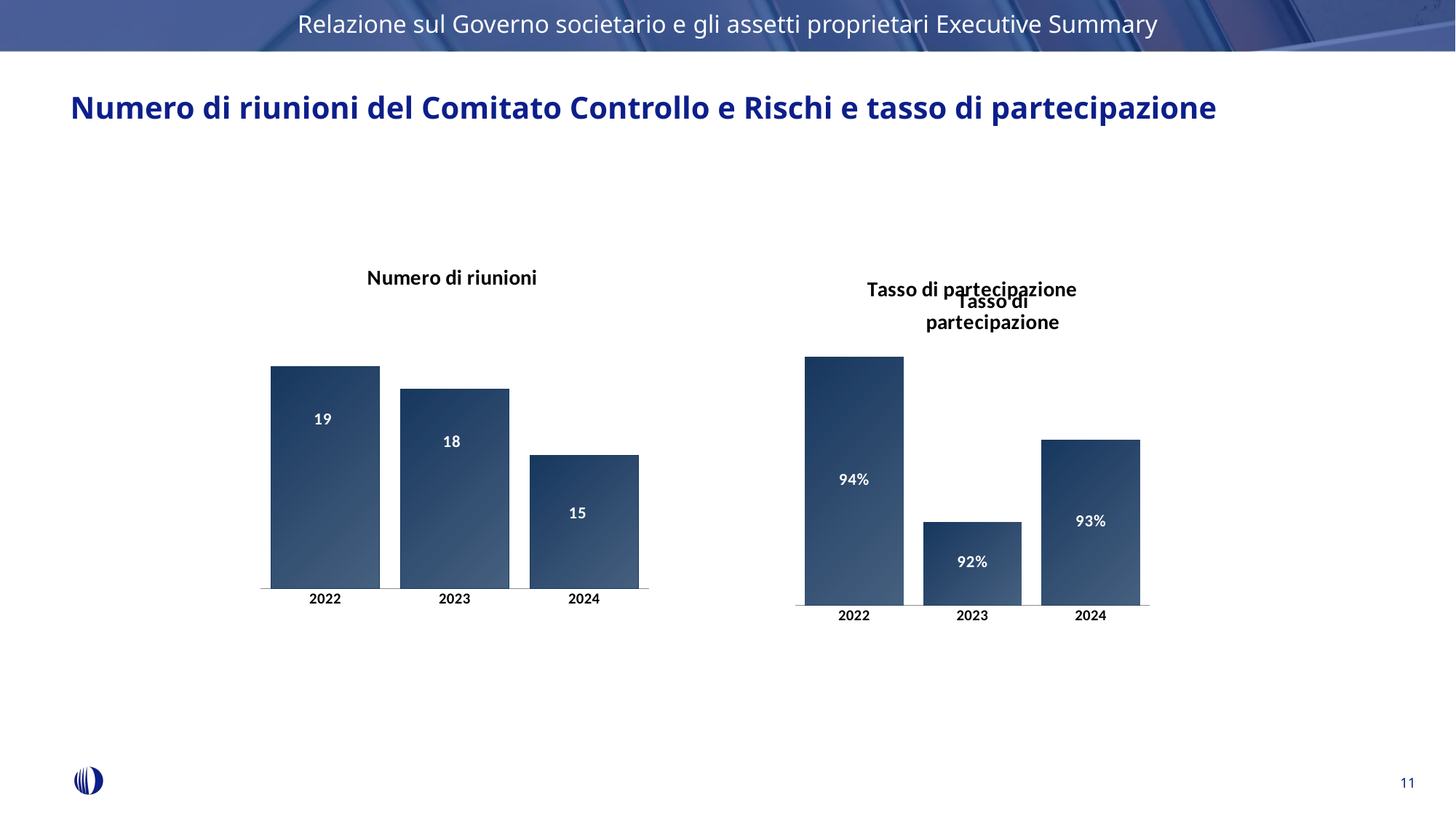
In the 'Tasso di partecipazione' chart, what is the difference between the values for 2022 and 2023? 2% How many years are shown in the 'Numero di riunioni' chart? 3 In the 'Tasso di partecipazione' chart, which year has the lowest value? 2023 In the 'Tasso di partecipazione' chart, what is the value for 2023? 92% What kind of chart is the 'Tasso di partecipazione' chart? Bar chart In the 'Numero di riunioni' chart, do the values rise or fall from 2022 to 2024? Fall In the 'Numero di riunioni' chart, which is larger, the value for 2023 or the value for 2024? 2023 In the 'Numero di riunioni' chart, what is the value for 2022? 19 In the 'Tasso di partecipazione' chart, what is the value for 2024? 93% In the 'Numero di riunioni' chart, what is the difference between the values for 2022 and 2024? 4 In the 'Numero di riunioni' chart, what is the value for 2024? 15 In the 'Numero di riunioni' chart, which year has the highest value? 2022